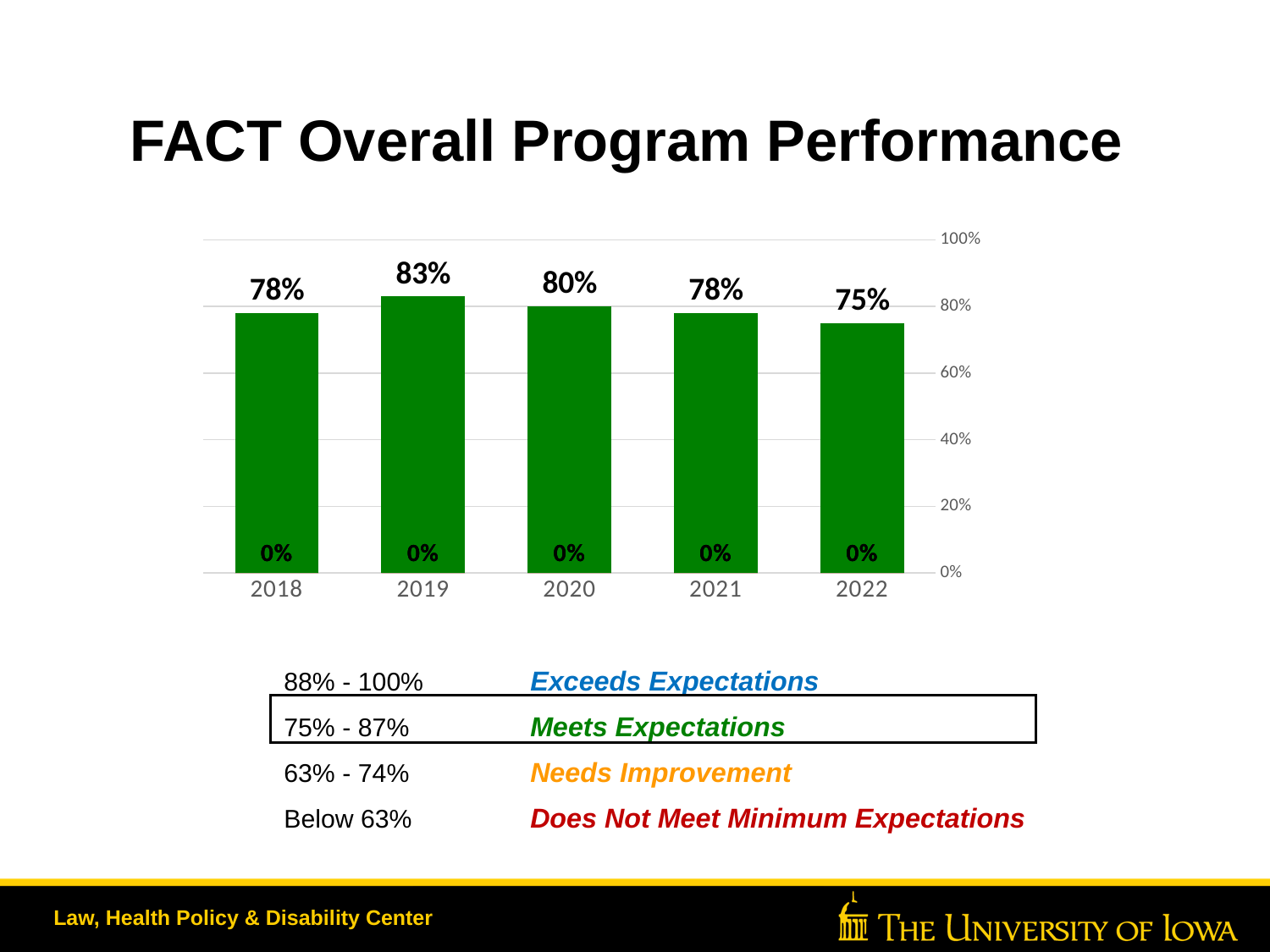
Which is larger, the value for 2020 or the value for 2021? 2020 What is the title of the slide containing the chart? FACT Overall Program Performance Do the values rise or fall from 2019 to 2022? fall What kind of chart is shown on the slide? bar chart What is the value for 2022? 75% Is the value for 2019 greater or less than 80%? greater How many years are shown on the x axis? 5 What is the value for 2020? 80% What is the value for 2019? 83% Which year has the lowest value? 2022 What is the difference between the values for 2019 and 2022? 8% Which year has the highest value? 2019